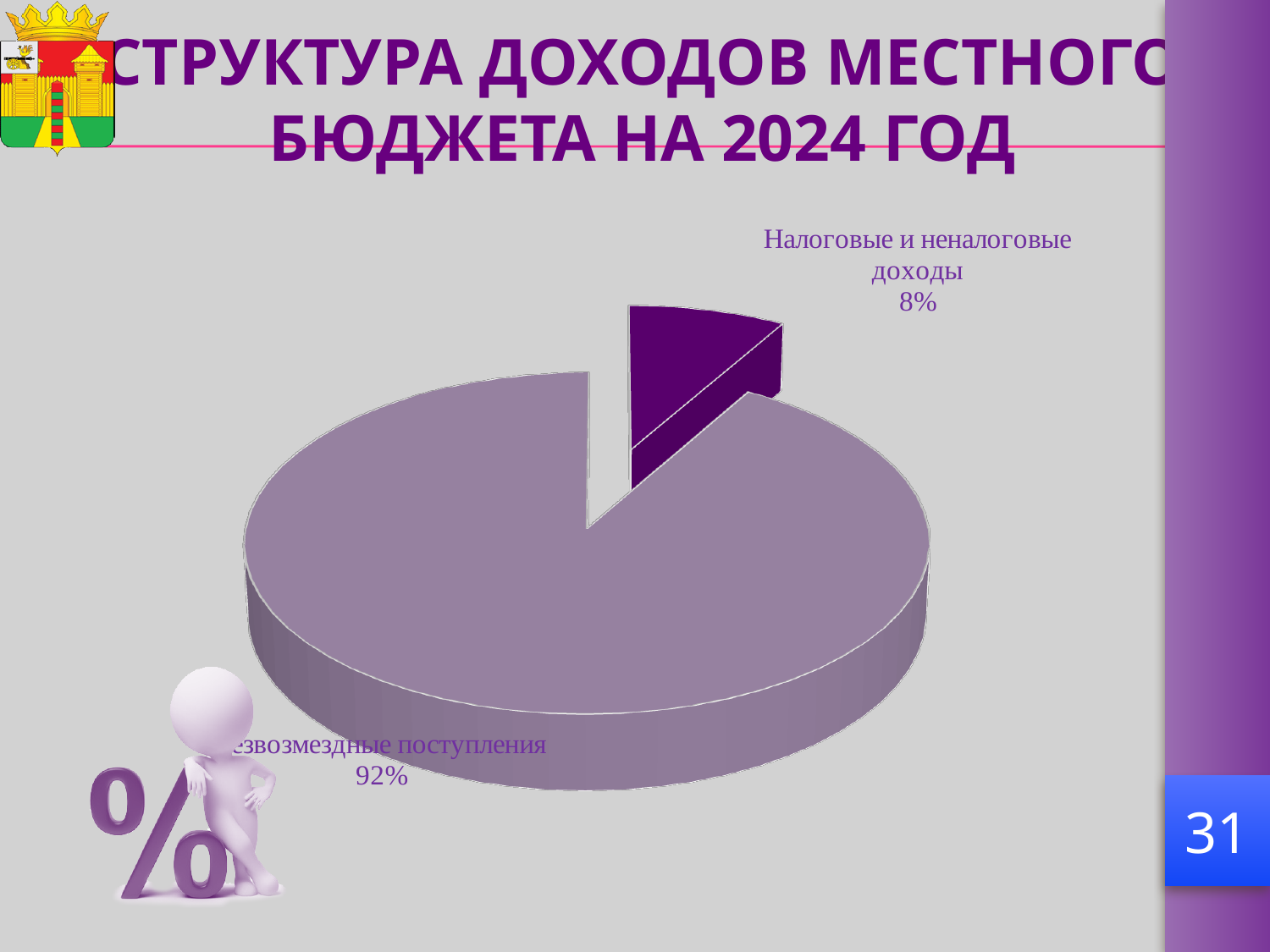
Which slice of the pie is the smallest? Налоговые и неналоговые доходы Which is larger: "Налоговые и неналоговые доходы" or "Безвозмездные поступления"? Безвозмездные поступления What is the title of the slide containing the pie chart? СТРУКТУРА ДОХОДОВ МЕСТНОГО БЮДЖЕТА НА 2024 ГОД What is the difference in percentage points between "Безвозмездные поступления" and "Налоговые и неналоговые доходы"? 84 How many slices does the pie chart have? 2 What share of the pie does "Налоговые и неналоговые доходы" take? 8% What kind of chart is shown on the slide? Pie chart What share of the pie does "Безвозмездные поступления" take? 92% Which slice of the pie is the largest? Безвозмездные поступления Which slice of the pie is drawn in dark purple and pulled out from the rest? Налоговые и неналоговые доходы